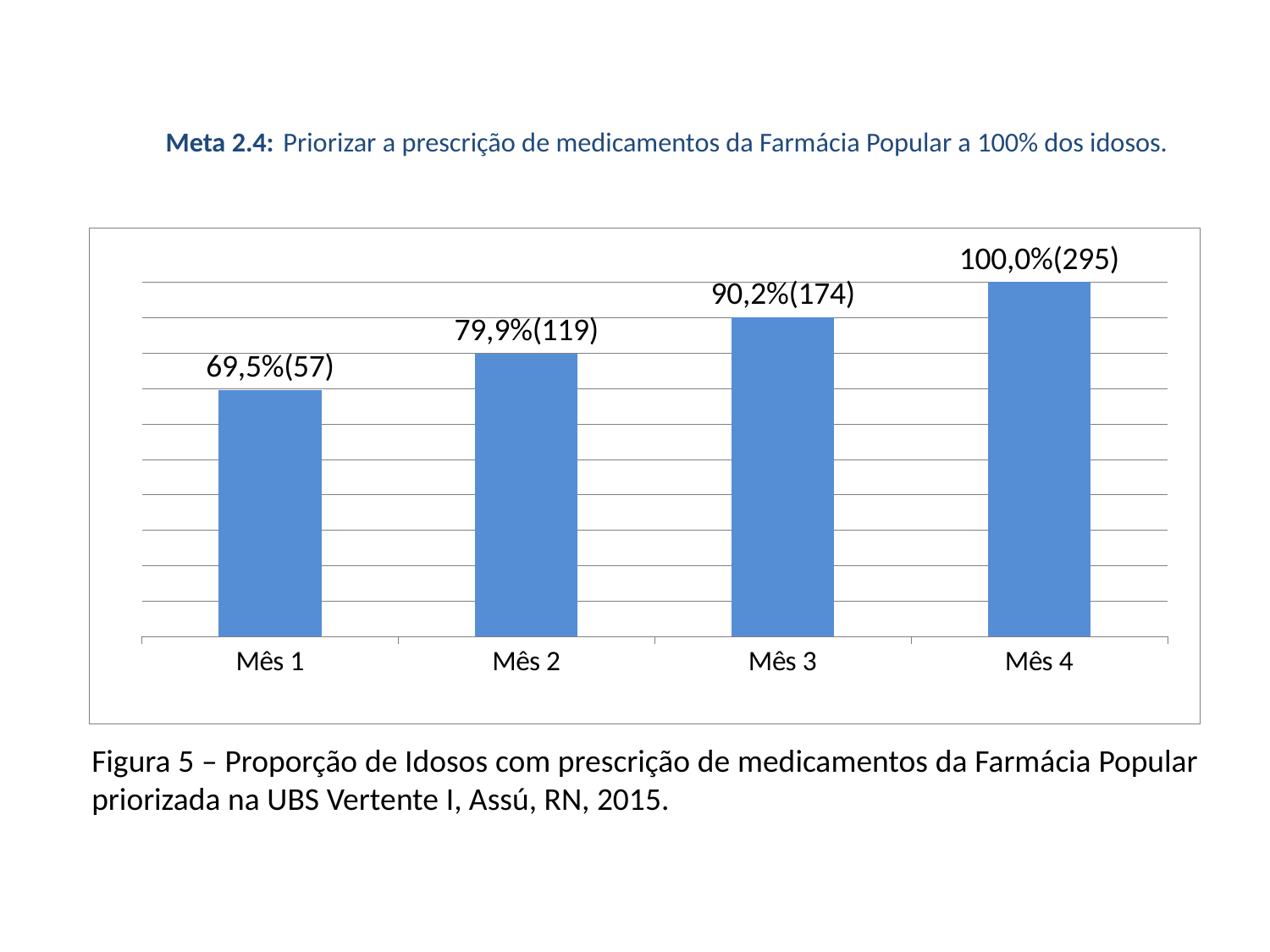
Which month has the lowest value? Mês 1 What kind of chart is shown? Bar chart How many months are shown on the x axis? 4 What is the data label shown for Mês 1? 69,5%(57) What is the difference between the counts in parentheses for Mês 3 and Mês 2? 55 What is the data label shown for Mês 3? 90,2%(174) Which month has the highest value? Mês 4 Do the values rise or fall from Mês 1 to Mês 4? Rise Which is larger, the value for Mês 2 or the value for Mês 3? Mês 3 What is the difference in percentage points between Mês 4 and Mês 1? 30,5 What percentage is shown for Mês 2? 79,9% What count is shown in parentheses for Mês 4? 295